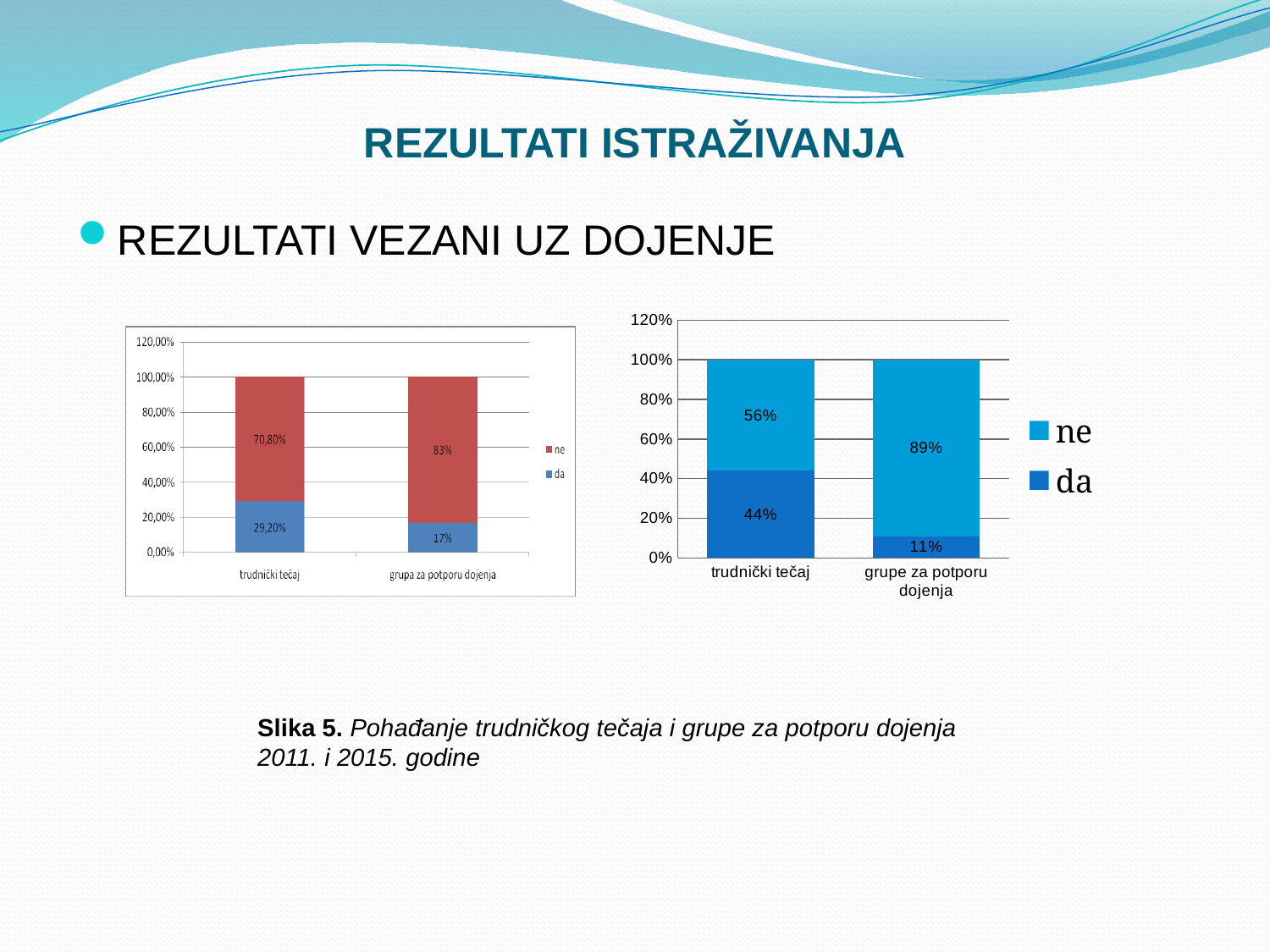
In the right chart, what is the value of the 'da' segment for grupe za potporu dojenja? 11% In the left chart, what is the value of the 'ne' segment for grupa za potporu dojenja? 83% How many categories are shown on the x axis of the left chart? 2 In the left chart, what is the value of the 'da' segment for trudnički tečaj? 29,20% In the right chart, what is the total of the stacked bar for trudnički tečaj? 100% In the right chart, which category has the higher 'da' value? trudnički tečaj In the right chart, what is the difference between the 'ne' values for grupe za potporu dojenja and trudnički tečaj? 33% In the left chart, is the 'ne' value for trudnički tečaj larger or smaller than the 'ne' value for grupa za potporu dojenja? smaller What kind of chart is the right chart? stacked bar chart In the left chart, which category has the lower 'da' value? grupa za potporu dojenja In the right chart, what is the value of the 'ne' segment for trudnički tečaj? 56% How many series does the legend of the right chart list? 2